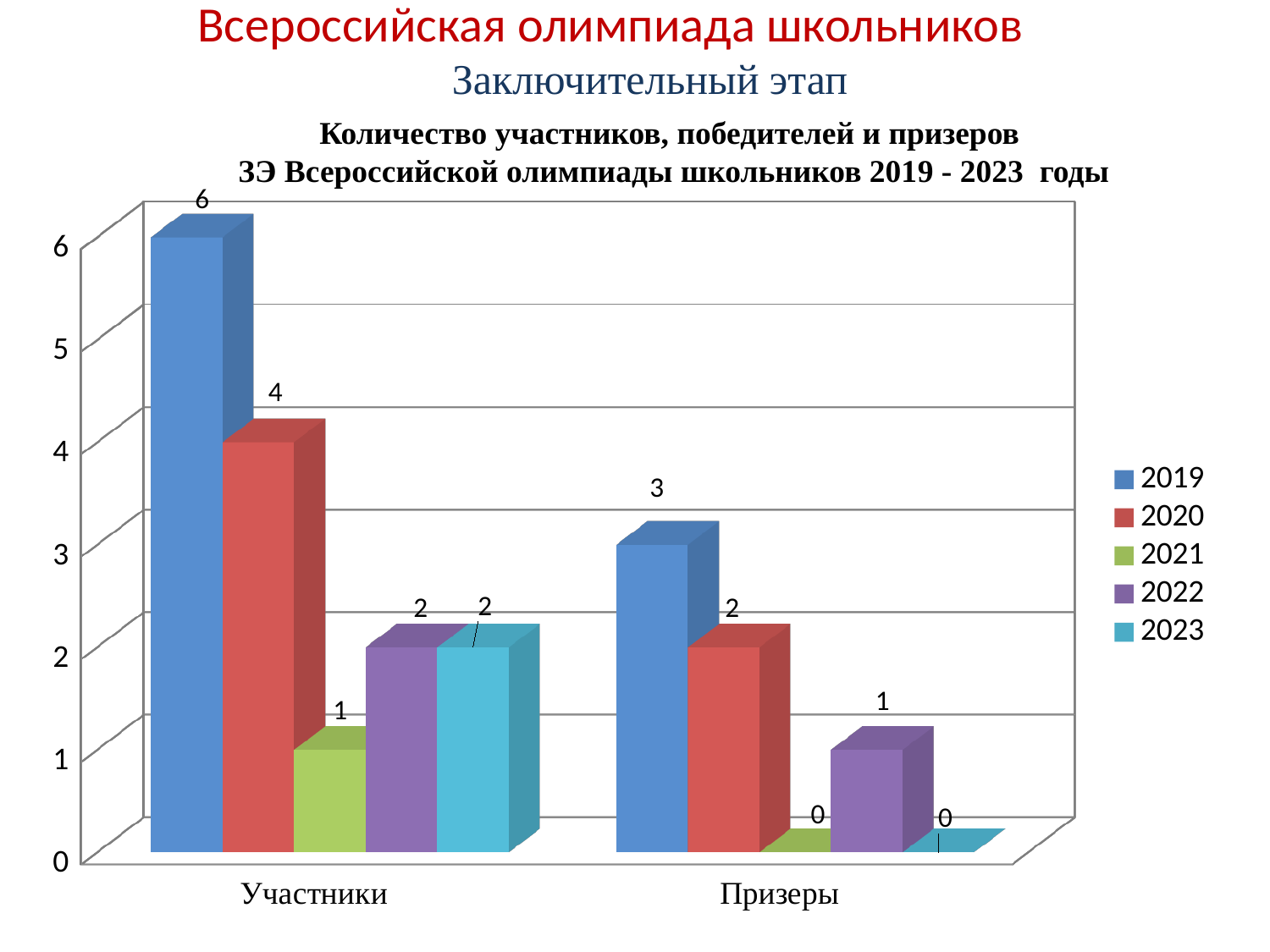
Which is larger: the 2019 value for Участники or the 2019 value for Призеры? Участники What is the value for 2020 in the Призеры category? 2 Which year is shown in purple in the legend? 2022 What is the value for 2022 in the Участники category? 2 How many series does the legend list? 5 What kind of chart is shown on the slide? bar chart How many categories are shown on the x axis? 2 What is the difference between the 2019 and 2020 values in the Участники category? 2 What is the value for 2019 in the Участники category? 6 Which year has the lowest value in the Участники category? 2021 Which year has the highest value in the Участники category? 2019 What is the value for 2021 in the Призеры category? 0